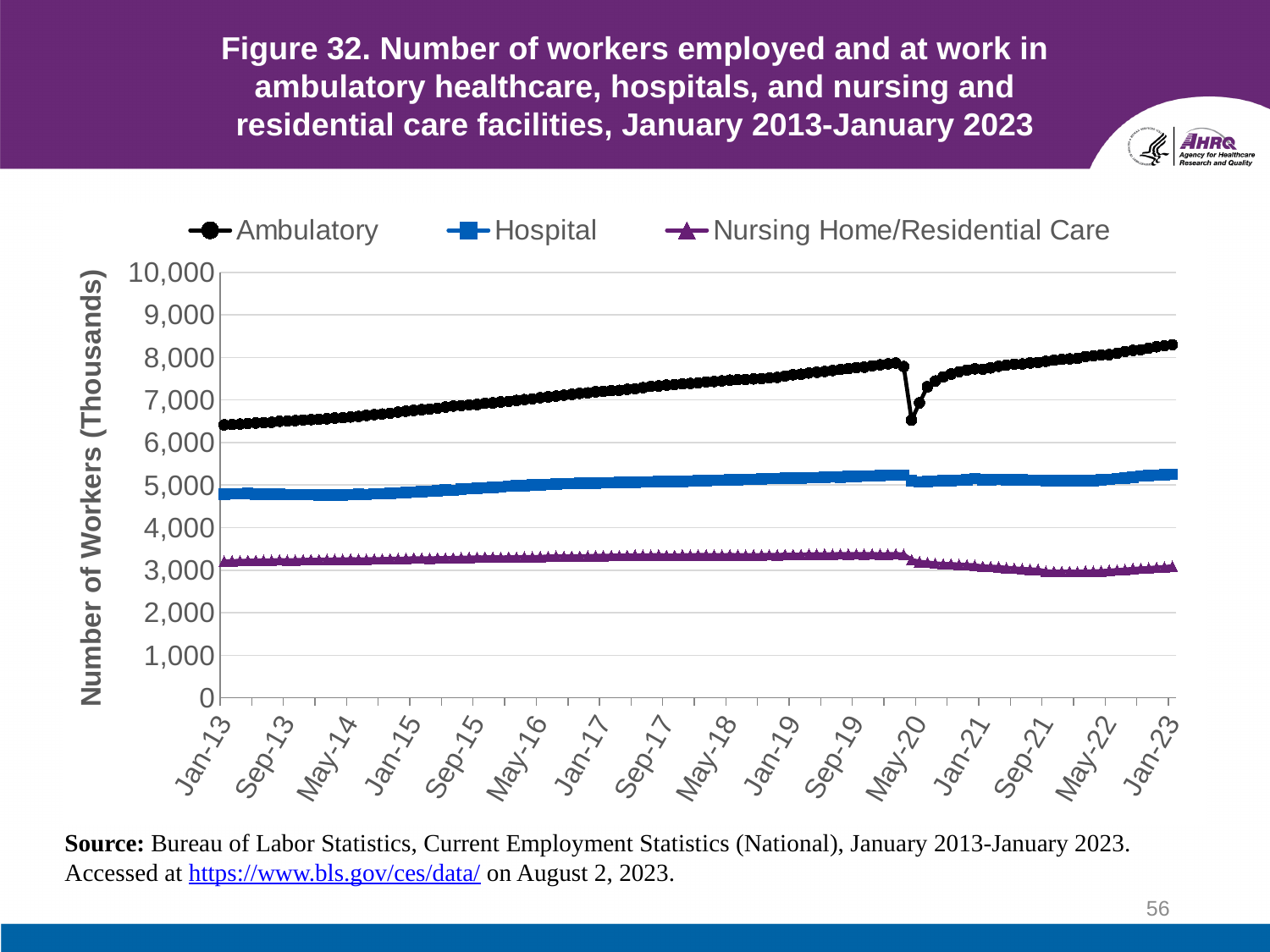
Which series has the highest number of workers throughout the period? Ambulatory Is the Ambulatory value in Jan-13 greater or less than 6,000? greater Does the Ambulatory line rise or fall overall from Jan-13 to Jan-23? rise What kind of chart is shown on the slide? line chart In Jan-13, which is larger: the Ambulatory value or the Hospital value? Ambulatory Is the Ambulatory value in Jan-23 greater or less than 8,000? greater Is the Hospital value in Jan-13 greater or less than 6,000? less What is the title of the y axis? Number of Workers (Thousands) Which series has the lowest number of workers throughout the period? Nursing Home/Residential Care How many series does the legend list? 3 What is the highest value shown on the y axis? 10,000